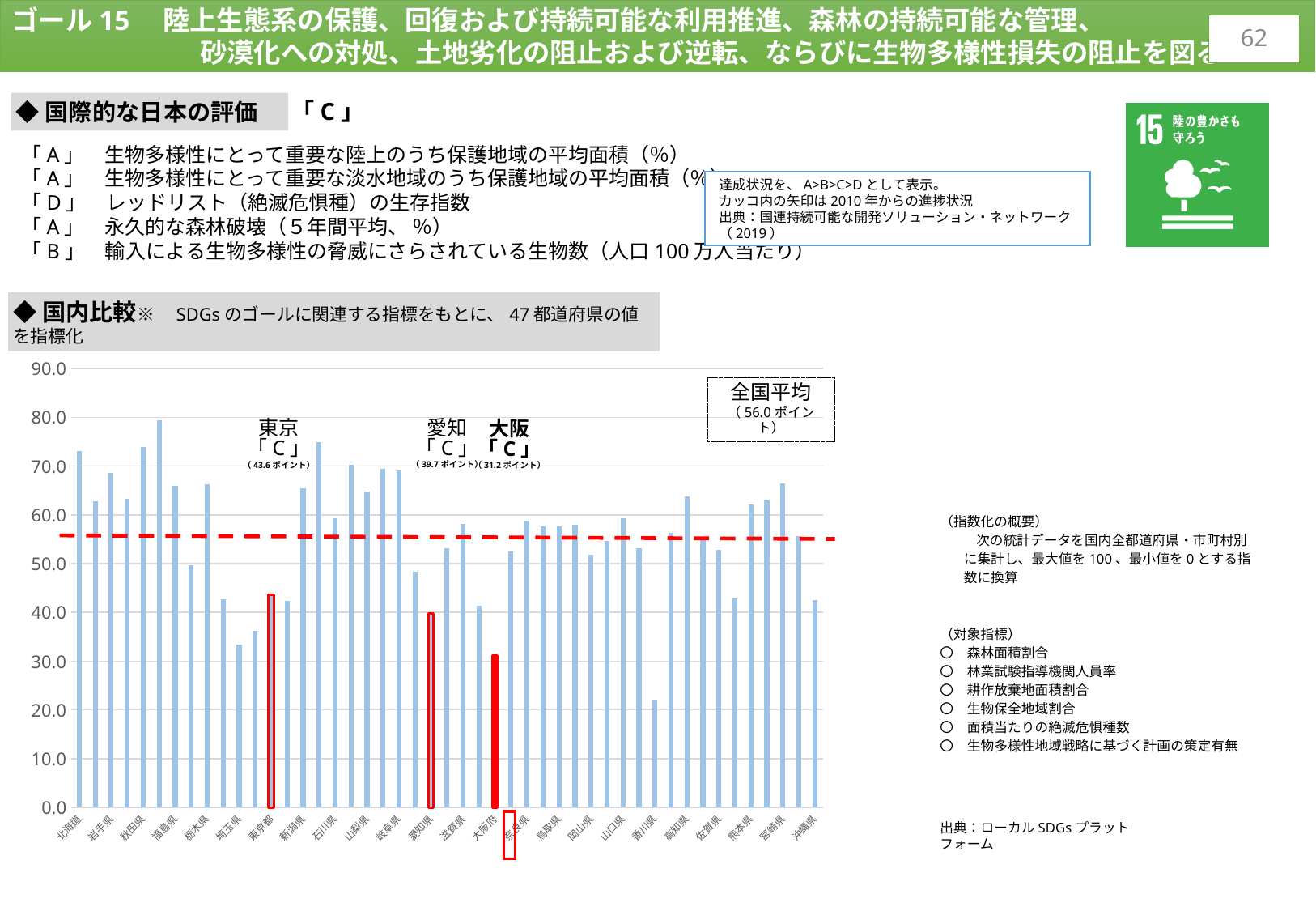
Which has the larger value, 東京 or 愛知? 東京 What does the red dashed horizontal line on the chart represent? 全国平均 (56.0 ポイント) Is the value for 沖縄県 greater or less than 50? less Is the value for 北海道 greater or less than 60? greater What is the value shown for 東京 on the chart? 43.6 ポイント What is the difference between the values for 東京 and 大阪? 12.4 ポイント What kind of chart is shown in the 国内比較 section? bar chart What is the value shown for 愛知 on the chart? 39.7 ポイント Is the value for 埼玉県 greater or less than 40? less What is the 全国平均 (national average) value shown on the chart? 56.0 ポイント What is the difference between the 全国平均 and the value for 愛知? 16.3 ポイント What is the value shown for 大阪 on the chart? 31.2 ポイント